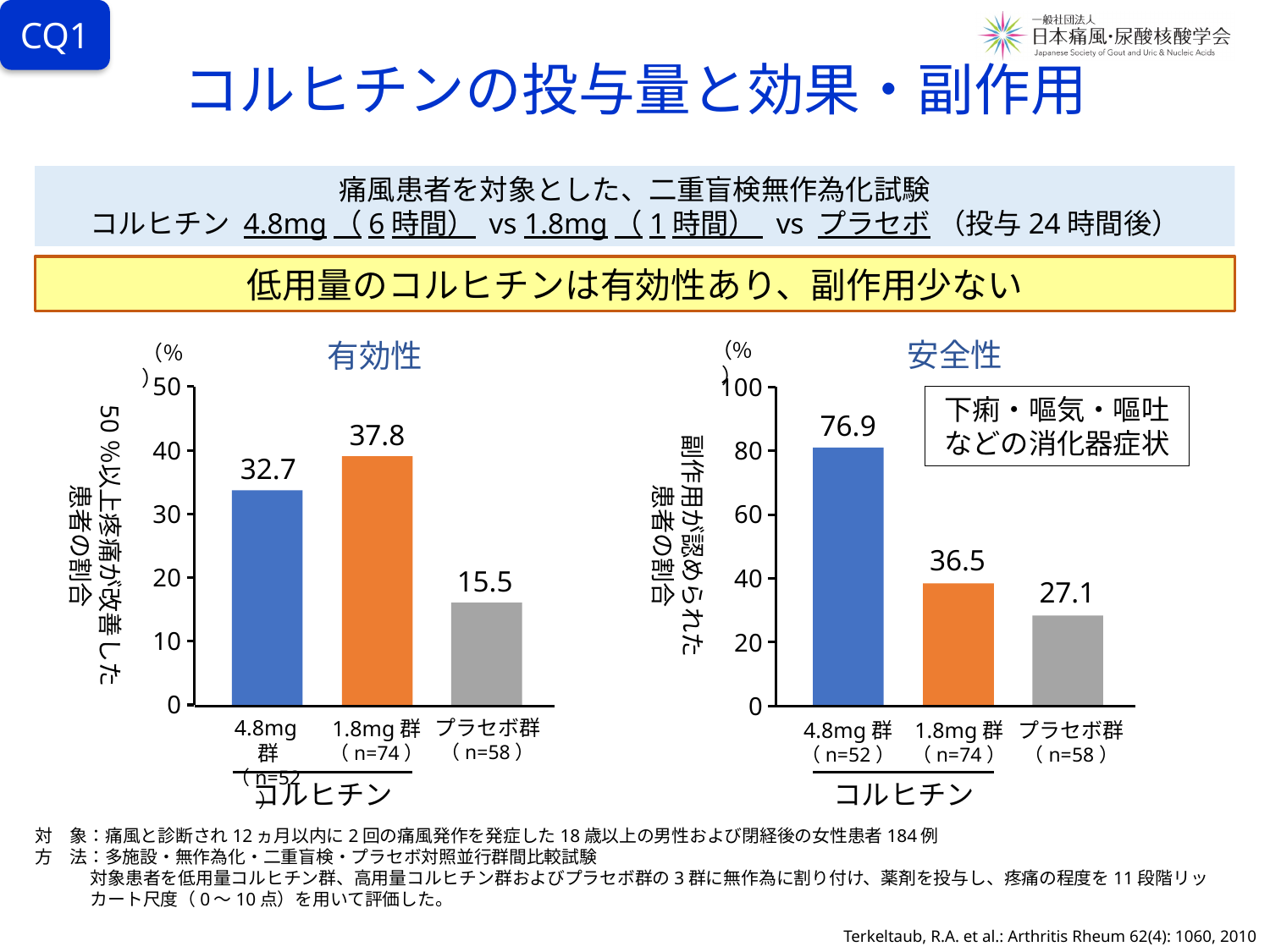
In the 有効性 chart, what is the value for the 1.8mg群 bar? 37.8 In the 安全性 chart, what is the difference between the 4.8mg群 and 1.8mg群 values? 40.4 In the 有効性 chart, what is the value for the プラセボ群 bar? 15.5 What type of chart is the 有効性 chart? Bar chart In the 有効性 chart, what is the difference between the 1.8mg群 and プラセボ群 values? 22.3 In the 安全性 chart, which group has the lowest value? プラセボ群 In the 安全性 chart, what is the value for the 4.8mg群 bar? 76.9 How many bars are shown in the 安全性 chart? 3 In the 有効性 chart, which group has the highest value? 1.8mg群 In the 安全性 chart, what is the value for the 1.8mg群 bar? 36.5 In the 有効性 chart, which is larger, the value for 4.8mg群 or for プラセボ群? 4.8mg群 In the 安全性 chart, do the values rise or fall from left to right? Fall